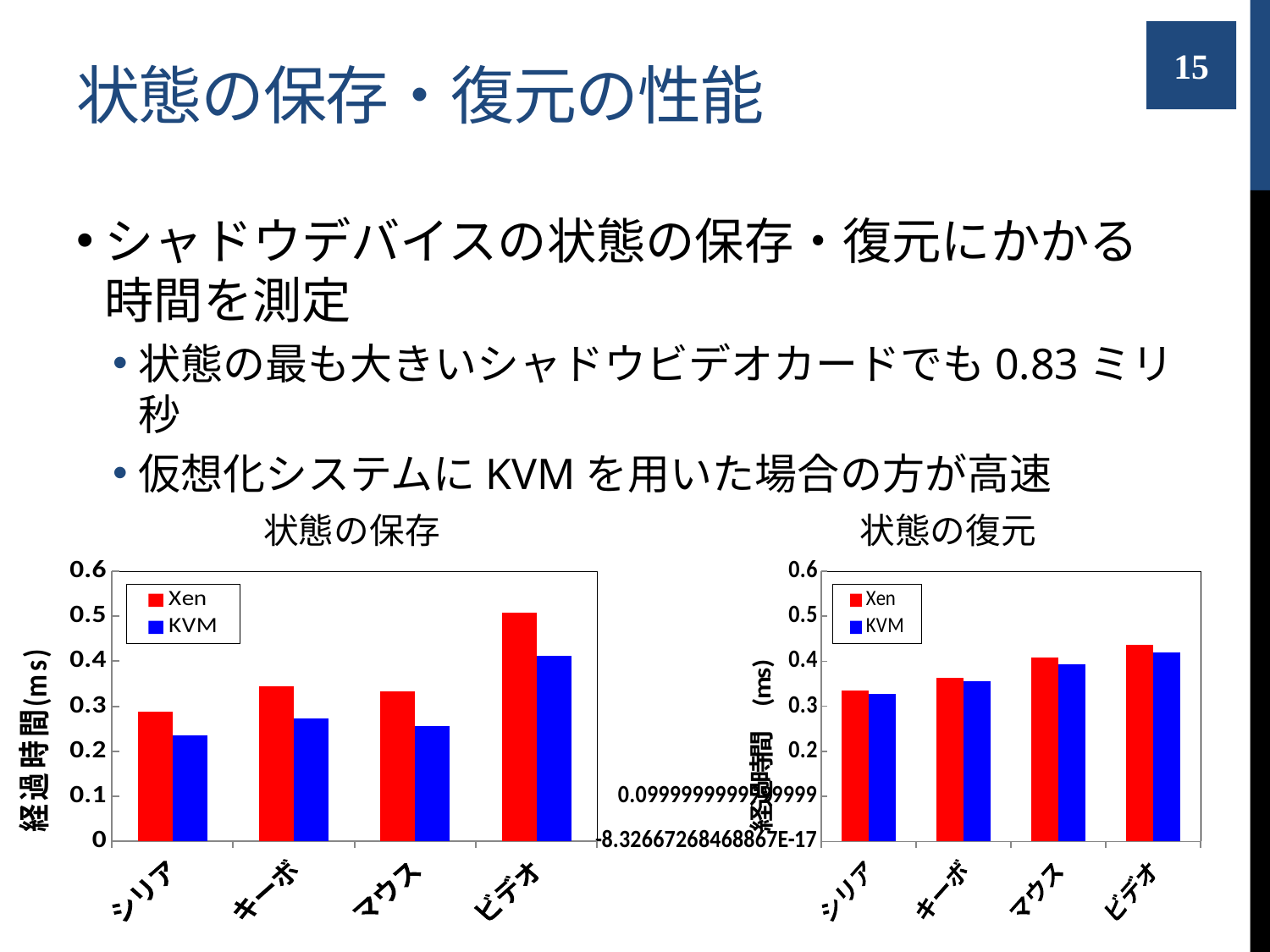
How many categories are shown on the x axis of the 状態の保存 chart? 4 What kind of chart is the 状態の保存 chart on the left? bar chart In the 状態の復元 chart, is the Xen value for ビデオ greater or less than 0.4? greater In the 状態の保存 chart, is the Xen value for ビデオ greater or less than 0.4? greater In the 状態の保存 chart, which colour represents the KVM series? blue In the 状態の復元 chart, is the KVM value for シリア greater or less than 0.4? less In the 状態の保存 chart, which category has the highest Xen value? ビデオ In the 状態の保存 chart, which category has the lowest KVM value? シリア In the 状態の保存 chart, for ビデオ, which is larger, Xen or KVM? Xen In the 状態の復元 chart, do the Xen values rise or fall from left to right along the x axis? rise How many series does the legend of the 状態の復元 chart list? 2